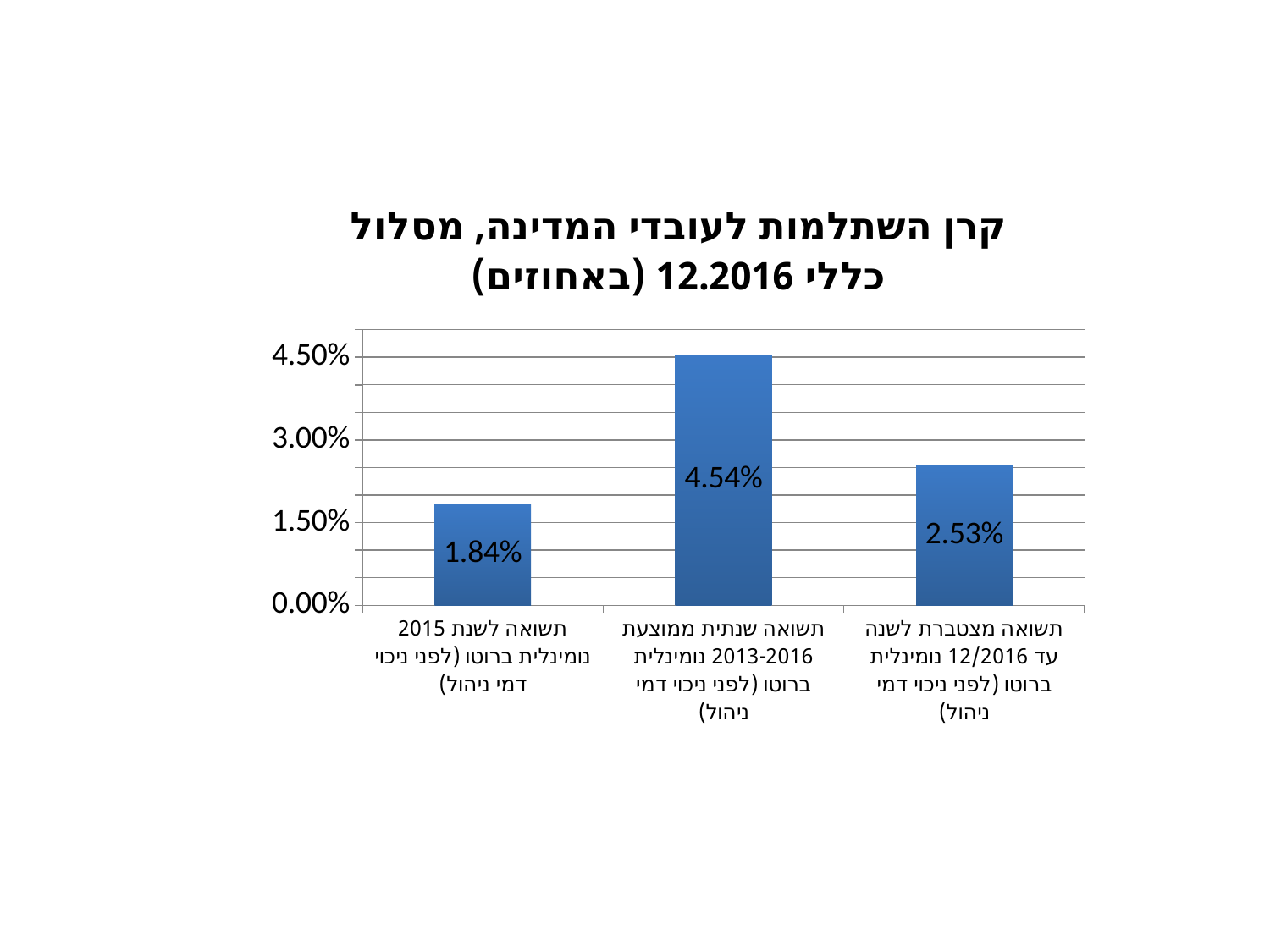
How many bars are shown in the chart? 3 What is the difference between the average annual return 2013-2016 and the 2015 return? 2.70% What is the difference between the cumulative return to 12/2016 and the 2015 return? 0.69% Is the value for the average annual return 2013-2016 greater or less than 3.00%? greater What is the title of the chart? קרן השתלמות לעובדי המדינה, מסלול כללי 12.2016 (באחוזים) What is the value for the 2015 return (תשואה לשנת 2015)? 1.84% Which is larger: the cumulative return to 12/2016 or the 2015 return? תשואה מצטברת לשנה עד 12/2016 What is the value for the average annual return 2013-2016 (תשואה שנתית ממוצעת 2013-2016)? 4.54% What is the value for the cumulative return for the year to 12/2016 (תשואה מצטברת לשנה עד 12/2016)? 2.53% Which category has the lowest value? תשואה לשנת 2015 נומינלית ברוטו (לפני ניכוי דמי ניהול) Which category has the highest value? תשואה שנתית ממוצעת 2013-2016 נומינלית ברוטו (לפני ניכוי דמי ניהול) What kind of chart is shown on the slide? bar chart